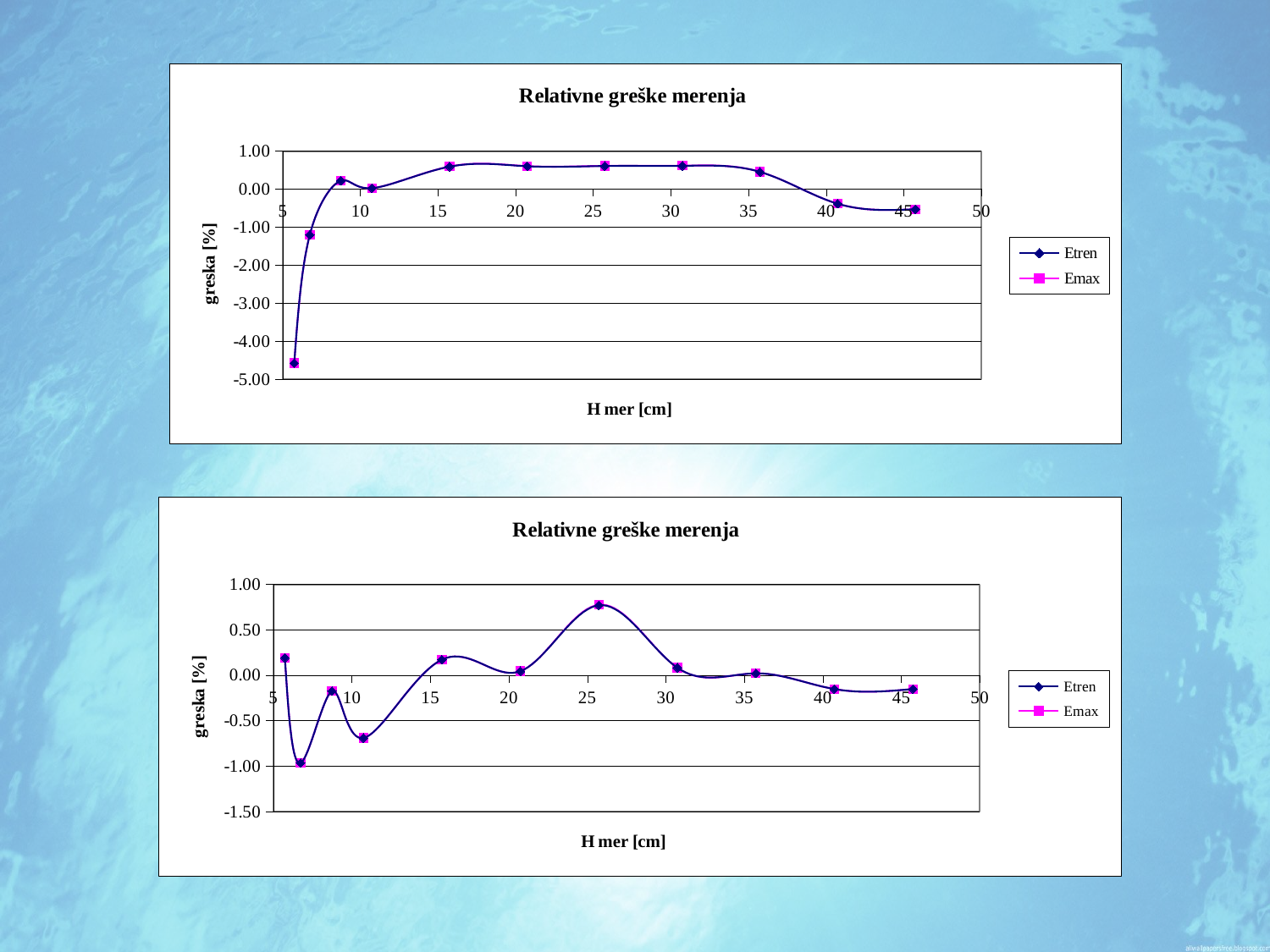
What kind of chart is the bottom chart on the slide? line chart In the top chart, is the lowest plotted value greater or less than -4.00? less In the bottom chart, is the highest plotted value greater or less than 0.50? greater How many series does the legend of the top chart list? 2 What are the two series named in the legend of the bottom chart? Etren and Emax In the bottom chart, is the lowest plotted value greater or less than -0.50? less What is the title of the top chart? Relativne greške merenja What kind of chart is the top chart on the slide? line chart In the top chart, which is larger: the value at H mer of about 16 cm or at about 41 cm? about 16 cm How many data points are plotted per series in the bottom chart? 11